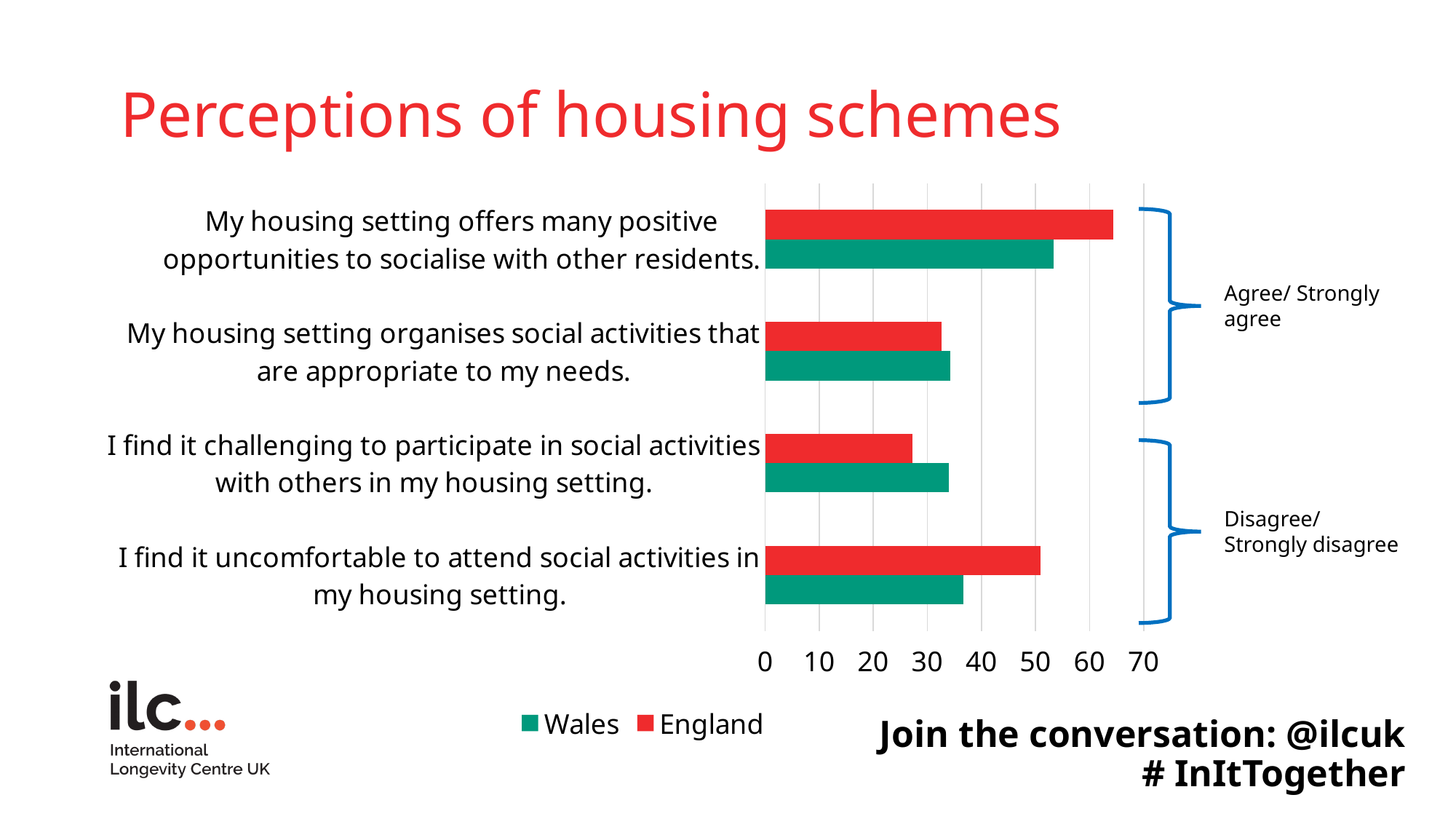
For the statement 'My housing setting offers many positive opportunities to socialise with other residents', which is larger, the Wales value or the England value? England For the statement 'I find it challenging to participate in social activities with others in my housing setting', which is larger, the Wales value or the England value? Wales How many series does the legend list? 2 For which statement is the England value lowest? I find it challenging to participate in social activities with others in my housing setting. Is the England value for 'My housing setting offers many positive opportunities to socialise with other residents' greater or less than 60? greater How many statements (categories) are plotted on the chart? 4 Which series is shown in red? England For which statement is the England value highest? My housing setting offers many positive opportunities to socialise with other residents. What is the title of the slide? Perceptions of housing schemes What kind of chart is shown on the slide? bar chart For which statement is the Wales value highest? My housing setting offers many positive opportunities to socialise with other residents. Is the England value for 'I find it challenging to participate in social activities with others in my housing setting' greater or less than 30? less